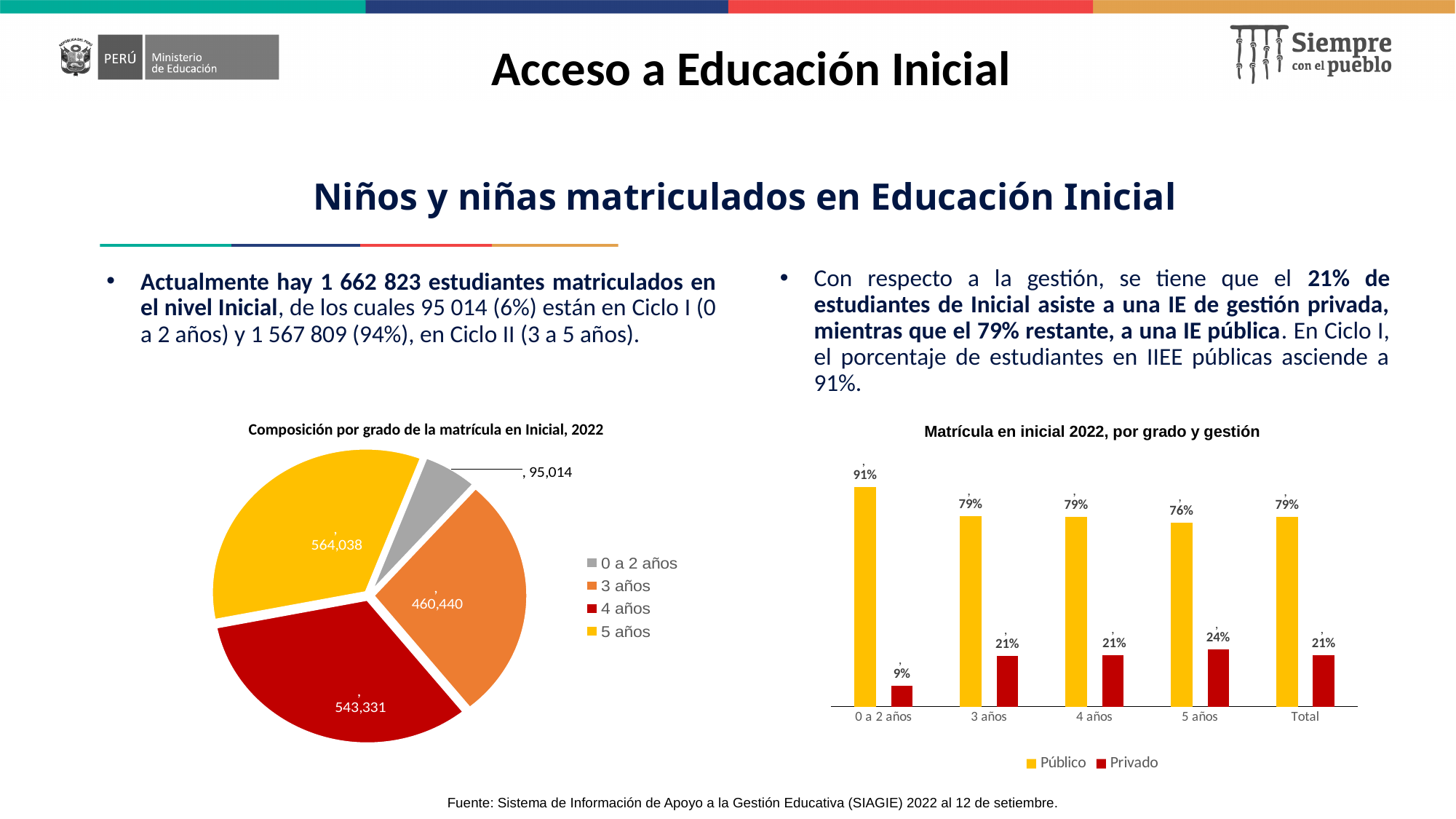
In the bar chart 'Matrícula en inicial 2022, por grado y gestión', how many series does the legend list? 2 In the pie chart 'Composición por grado de la matrícula en Inicial, 2022', how many categories does the legend list? 4 In the bar chart 'Matrícula en inicial 2022, por grado y gestión', what is the Privado value for 5 años? 24% In the pie chart 'Composición por grado de la matrícula en Inicial, 2022', what is the value for 0 a 2 años? 95,014 In the bar chart 'Matrícula en inicial 2022, por grado y gestión', which category has the lowest Público value? 5 años In the pie chart 'Composición por grado de la matrícula en Inicial, 2022', what is the value for 4 años? 543,331 In the bar chart 'Matrícula en inicial 2022, por grado y gestión', what is the Público value for 0 a 2 años? 91% In the bar chart 'Matrícula en inicial 2022, por grado y gestión', which is larger for 3 años: Público or Privado? Público In the pie chart 'Composición por grado de la matrícula en Inicial, 2022', what is the difference between the values for 5 años and 4 años? 20,707 What type of chart is 'Composición por grado de la matrícula en Inicial, 2022'? Pie chart In the pie chart 'Composición por grado de la matrícula en Inicial, 2022', which category has the smallest slice? 0 a 2 años In the pie chart 'Composición por grado de la matrícula en Inicial, 2022', which category has the largest slice? 5 años